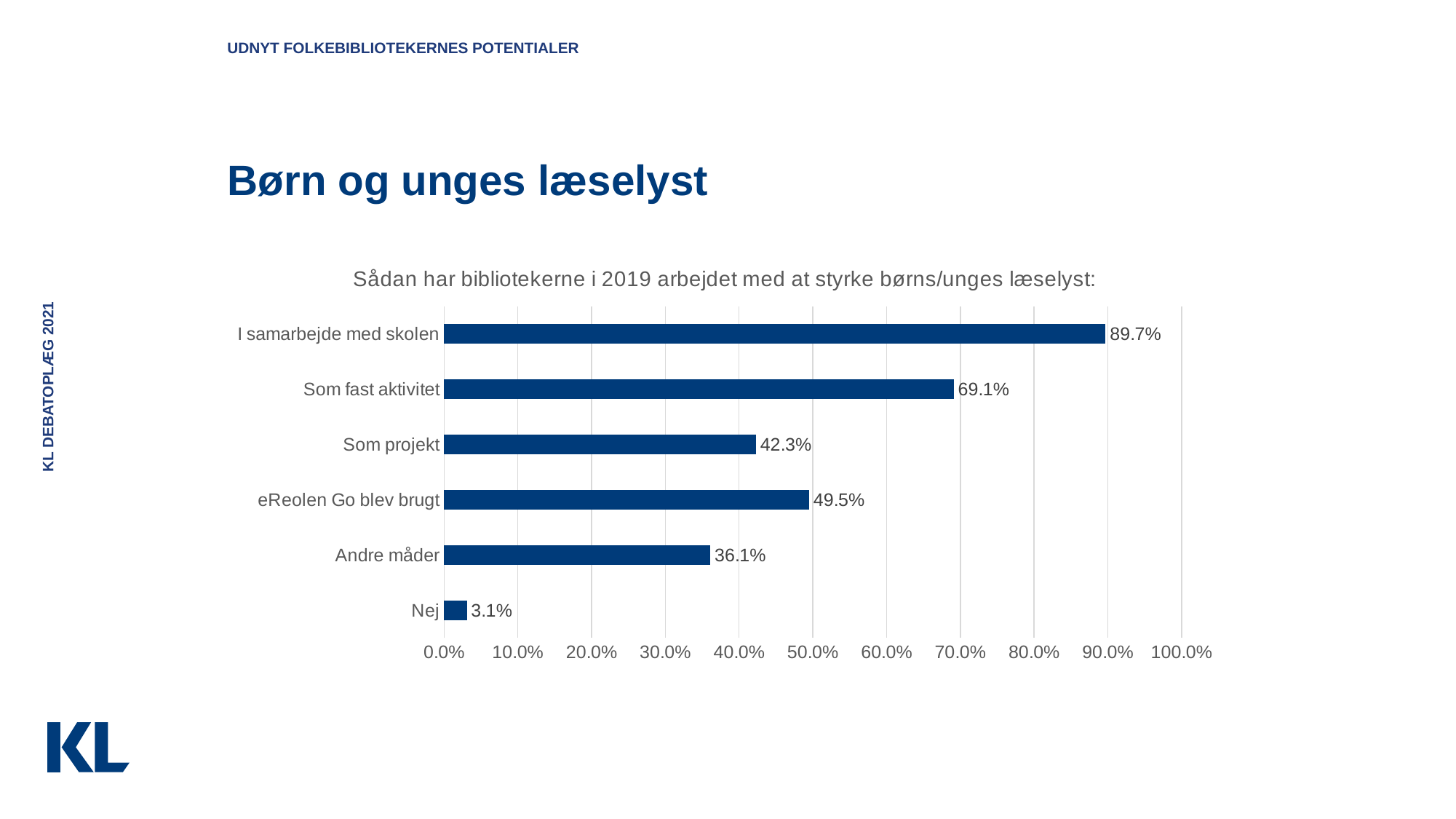
What kind of chart is shown on the slide? Bar chart What is the title of the chart? Sådan har bibliotekerne i 2019 arbejdet med at styrke børns/unges læselyst: What is the value for "eReolen Go blev brugt"? 49.5% What is the value for "Andre måder"? 36.1% What is the difference between the values for "Som fast aktivitet" and "Som projekt"? 26.8% Which is larger, the value for "eReolen Go blev brugt" or the value for "Andre måder"? eReolen Go blev brugt How many categories are shown in the chart? 6 Is the value for "Som projekt" greater or less than 50.0%? less Which category has the lowest value? Nej Which category has the highest value? I samarbejde med skolen What is the value for "Nej"? 3.1% What is the value for "I samarbejde med skolen"? 89.7%